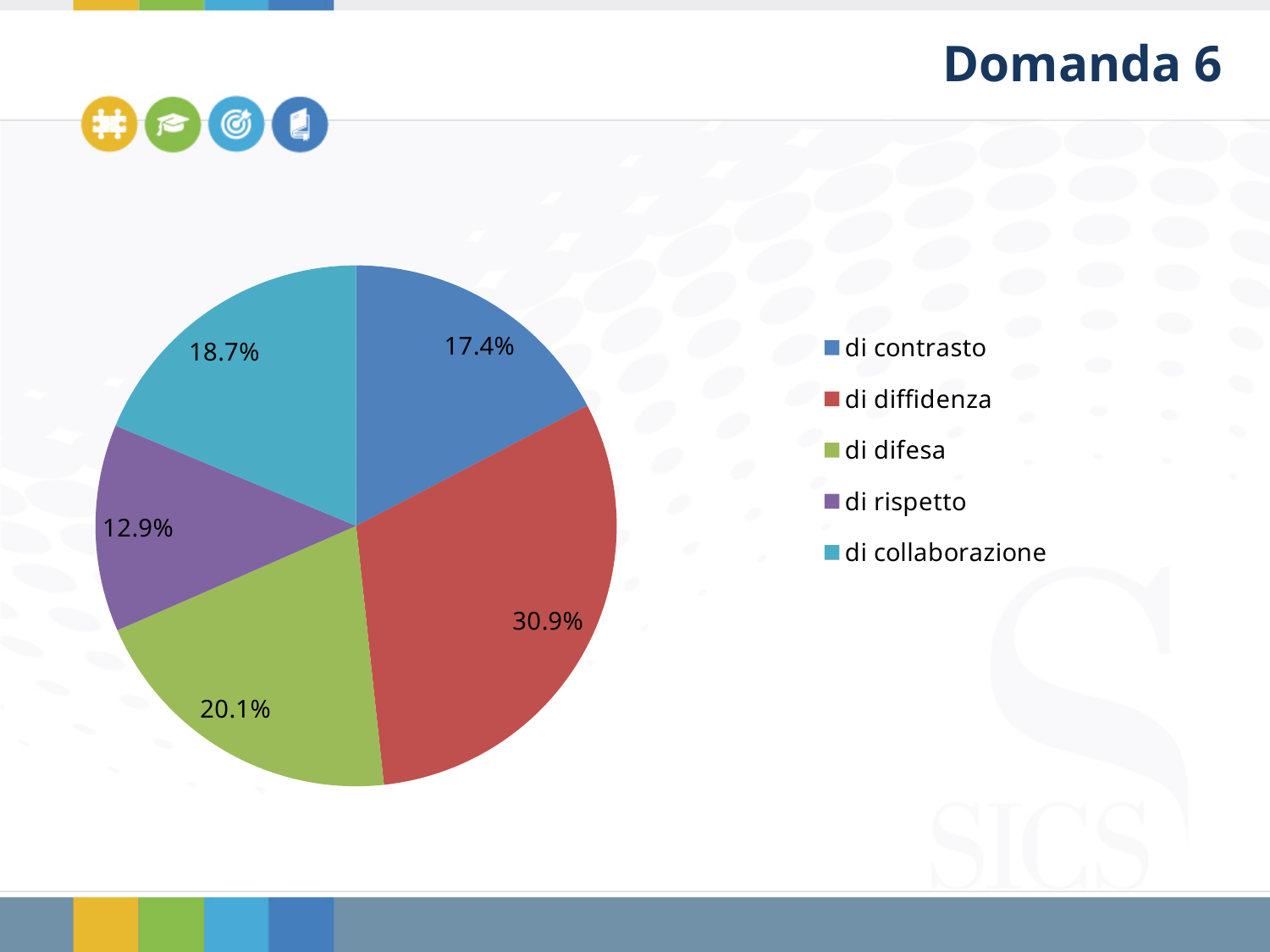
How many entries does the legend list? 5 Which category has the smallest slice? di rispetto What kind of chart is shown on the slide? pie chart What is the value for "di rispetto"? 12.9% What is the value for "di diffidenza"? 30.9% What colour is the slice for "di difesa"? green Which category has the largest slice? di diffidenza What is the difference between the values for "di diffidenza" and "di difesa"? 10.8% Which is larger, "di collaborazione" or "di contrasto"? di collaborazione What is the value for "di contrasto"? 17.4% What is the value for "di collaborazione"? 18.7% How many slices does the pie chart have? 5